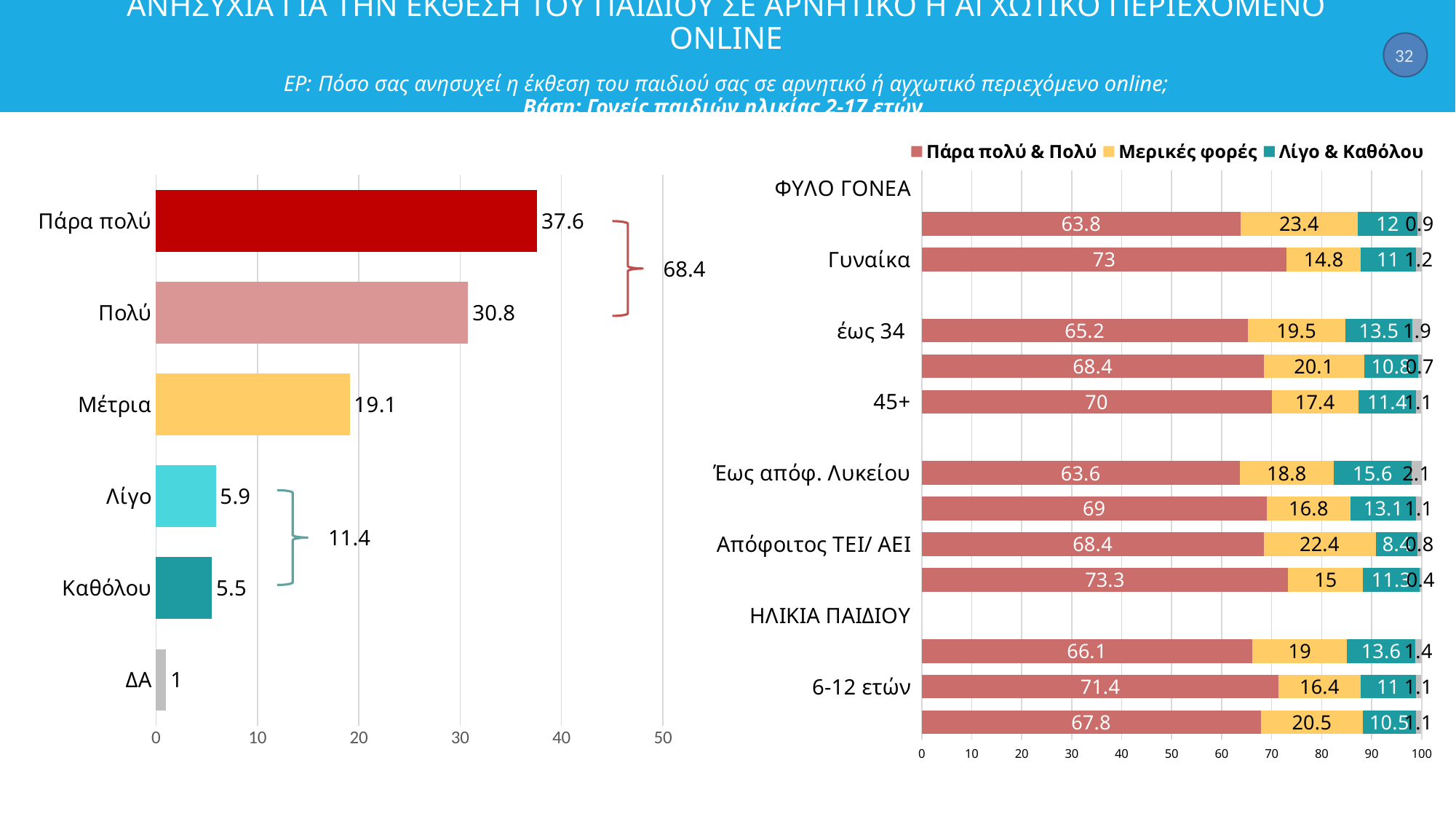
In the right chart, what is the value of Λίγο & Καθόλου for Έως απόφ. Λυκείου? 15.6 In the left bar chart, how many categories are shown? 6 In the left bar chart, is the value for Λίγο greater or less than Καθόλου? greater In the right chart, what is the value of Μερικές φορές for Απόφοιτος ΤΕΙ/ ΑΕΙ? 22.4 What kind of chart is the chart on the right side of the slide? Stacked bar chart In the left bar chart, which category has the lowest value? ΔΑ In the left bar chart, what is the value for Πάρα πολύ? 37.6 In the left bar chart, which category has the highest value? Πάρα πολύ In the right chart, what is the value of Πάρα πολύ & Πολύ for Γυναίκα? 73 In the left bar chart, what is the difference between the values for Πάρα πολύ and Πολύ? 6.8 In the right chart, how many series does the legend list? 3 In the left bar chart, what is the value for Μέτρια? 19.1